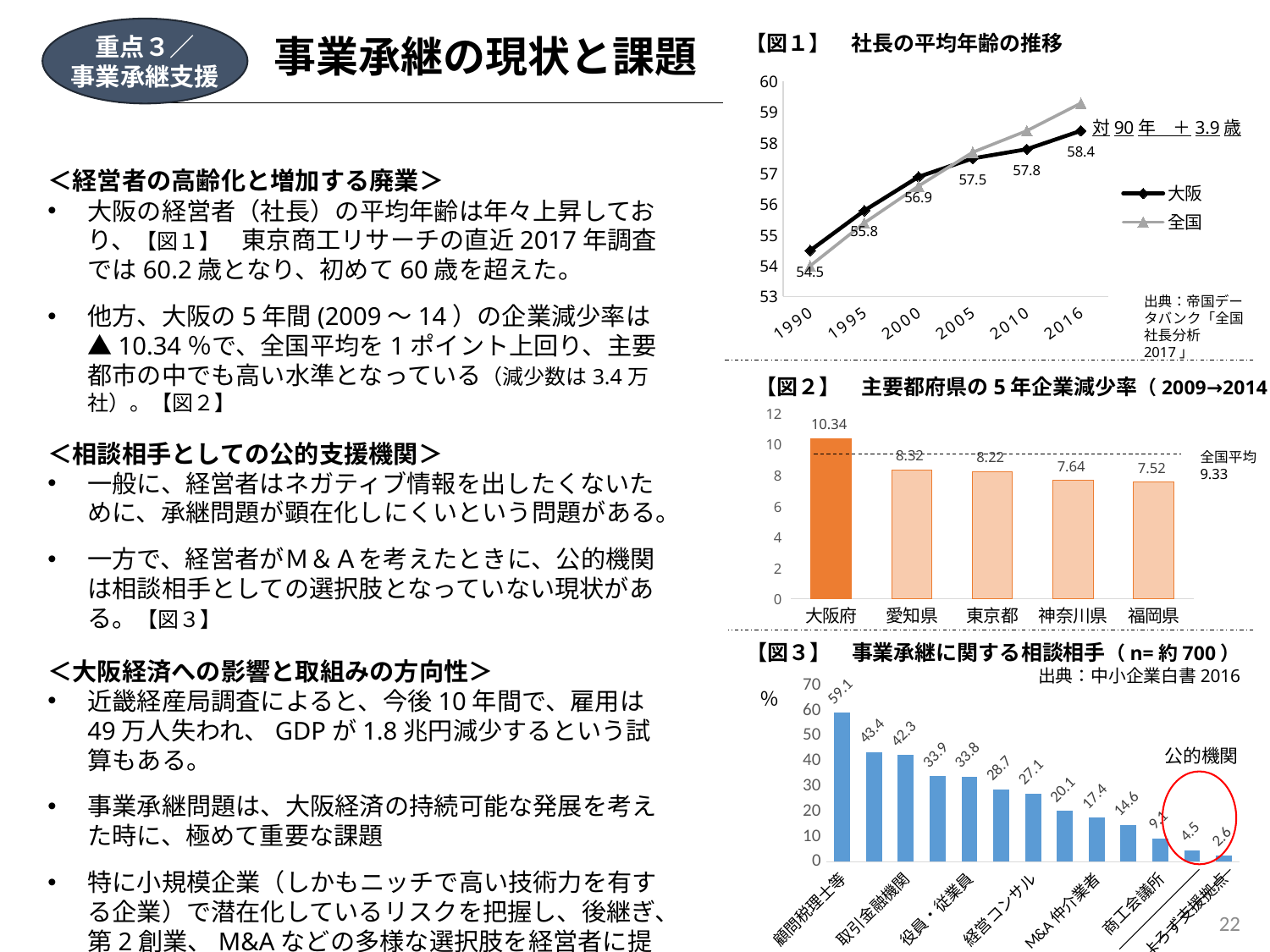
How many prefectures are plotted in 【図2】 主要都府県の5年企業減少率? 5 In 【図2】 主要都府県の5年企業減少率, what is the 全国平均 value shown by the dashed line? 9.33 What kind of chart is 【図1】 社長の平均年齢の推移? line chart In 【図2】 主要都府県の5年企業減少率, which prefecture has the highest value? 大阪府 In 【図1】 社長の平均年齢の推移, what is the value for 大阪 in 1990? 54.5 In 【図2】 主要都府県の5年企業減少率, which prefecture has the lowest value? 福岡県 How many series does the legend of 【図1】 社長の平均年齢の推移 list? 2 In 【図2】 主要都府県の5年企業減少率, what is the value for 東京都? 8.22 In 【図1】 社長の平均年齢の推移, what is the value for 大阪 in 2016? 58.4 In 【図3】 事業承継に関する相談相手, what is the highest value shown on any bar? 59.1 In 【図1】 社長の平均年齢の推移, by how much did the 大阪 value increase from 1990 to 2016? 3.9 In 【図1】 社長の平均年齢の推移, do the 大阪 values rise or fall from 1990 to 2016? rise